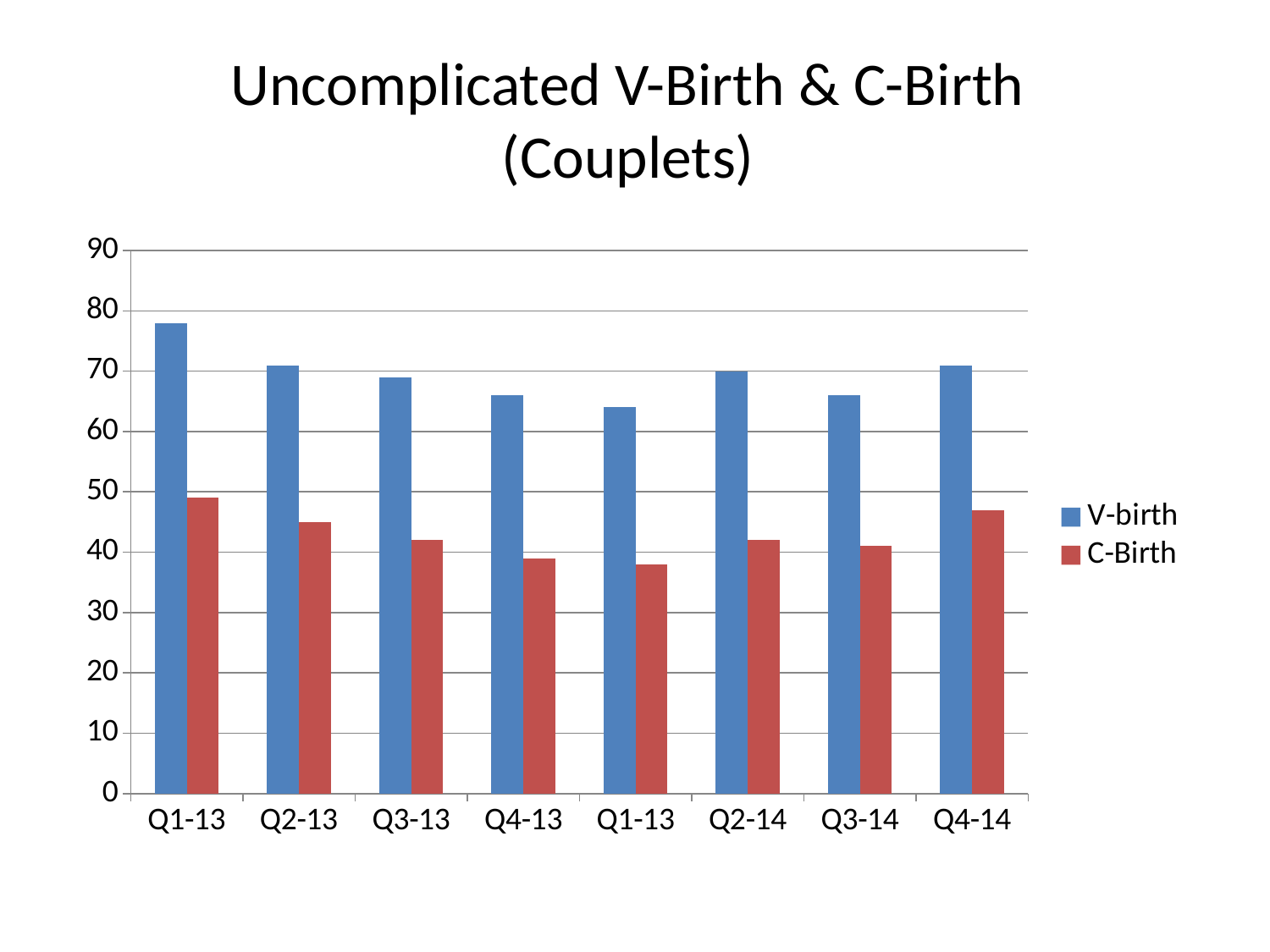
In Q2-14, which series has the larger value, V-birth or C-Birth? V-birth How many series does the legend list? 2 What kind of chart is shown on the slide? bar chart What is the title of the chart? Uncomplicated V-Birth & C-Birth (Couplets) Is the C-Birth value for Q2-13 greater or less than 40? greater Is the V-birth value for Q2-14 greater or less than 60? greater How many quarters are shown along the x axis? 8 Is the V-birth value for Q4-13 greater or less than 70? less Which is larger, the V-birth value for Q4-14 or the V-birth value for Q3-14? Q4-14 Which colour represents the C-Birth series? red Which quarter has the highest V-birth value? Q1-13 (the first quarter shown)